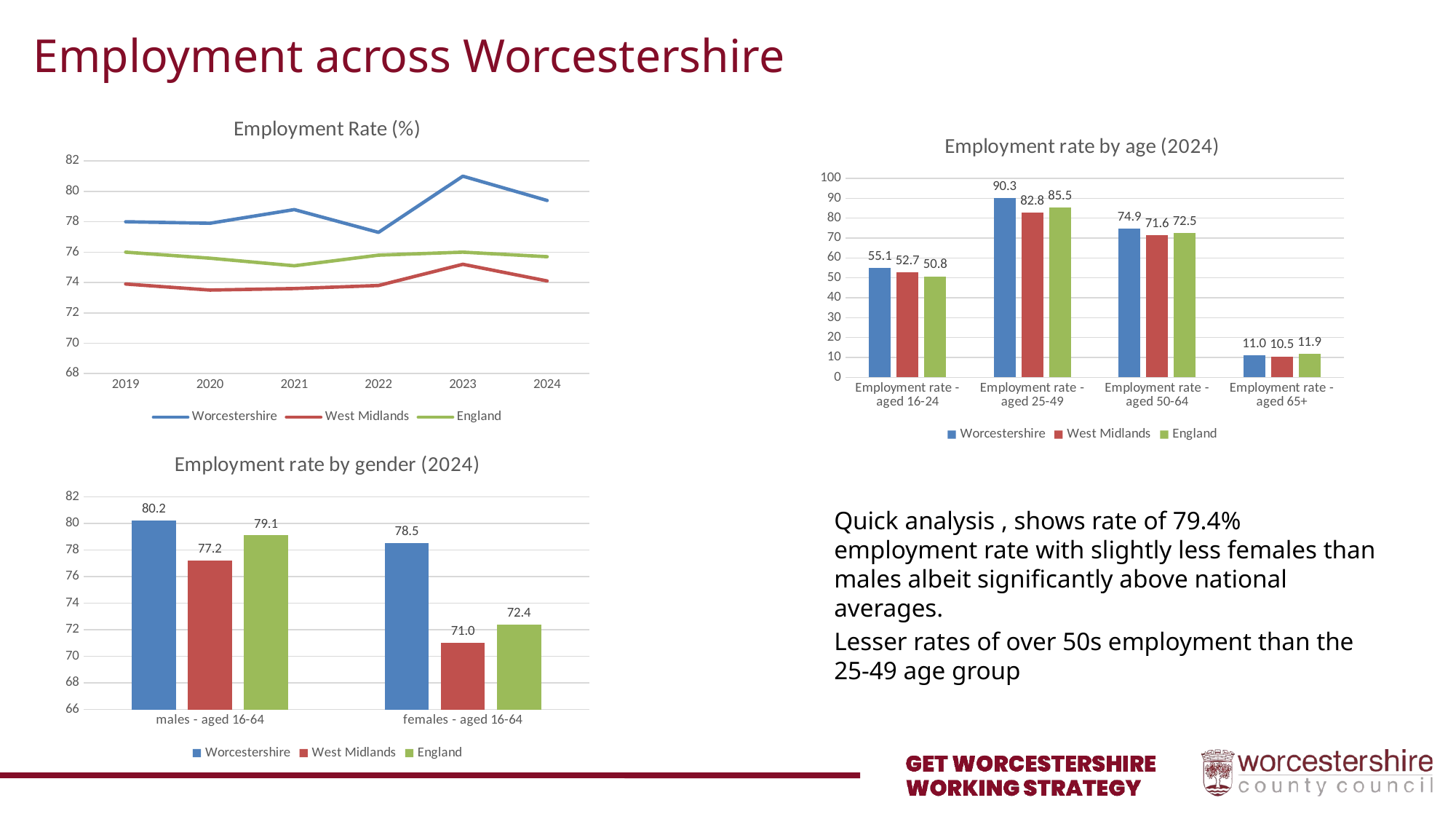
In the 'Employment rate by age (2024)' chart, what is the England value for those aged 65+? 11.9 In the 'Employment Rate (%)' chart, which series has the highest values across all years? Worcestershire How many series does the legend of the 'Employment Rate (%)' chart list? 3 What kind of chart is the 'Employment Rate (%)' chart? Line chart In the 'Employment rate by age (2024)' chart, how many age groups are shown? 4 In the 'Employment Rate (%)' chart, is the Worcestershire value for 2023 greater or less than 80? greater In the 'Employment rate by age (2024)' chart, which is larger for those aged 50-64: West Midlands or England? England In the 'Employment rate by gender (2024)' chart, what is the value for West Midlands for females aged 16-64? 71.0 In the 'Employment rate by gender (2024)' chart, what is the difference between the Worcestershire values for males and females aged 16-64? 1.7 In the 'Employment rate by age (2024)' chart, which age group has the lowest employment rates? Employment rate - aged 65+ In the 'Employment rate by age (2024)' chart, what is the Worcestershire value for those aged 25-49? 90.3 In the 'Employment rate by gender (2024)' chart, what is the value for Worcestershire for males aged 16-64? 80.2